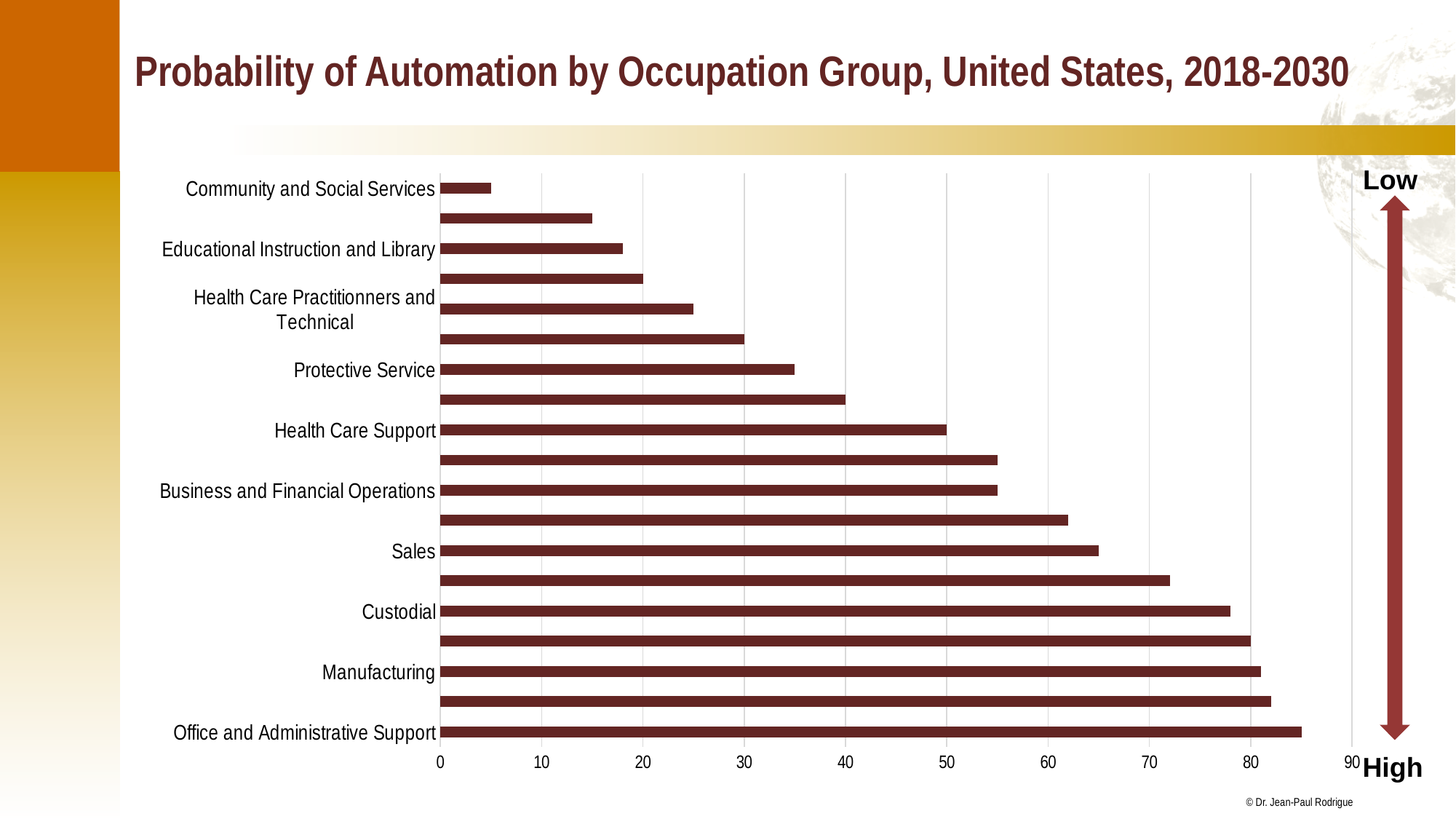
Do the bar values increase or decrease going from the top of the chart to the bottom? increase Which occupation group has the highest probability of automation? Office and Administrative Support What is the value for Health Care Support? 50 Is the value for Educational Instruction and Library greater or less than 20? less What kind of chart is shown on the slide? bar chart Is the value for Protective Service greater or less than 40? less Is the value for Office and Administrative Support greater or less than 80? greater What is the title of the chart? Probability of Automation by Occupation Group, United States, 2018-2030 Which has a higher probability of automation, Custodial or Business and Financial Operations? Custodial Which occupation group has the lowest probability of automation? Community and Social Services